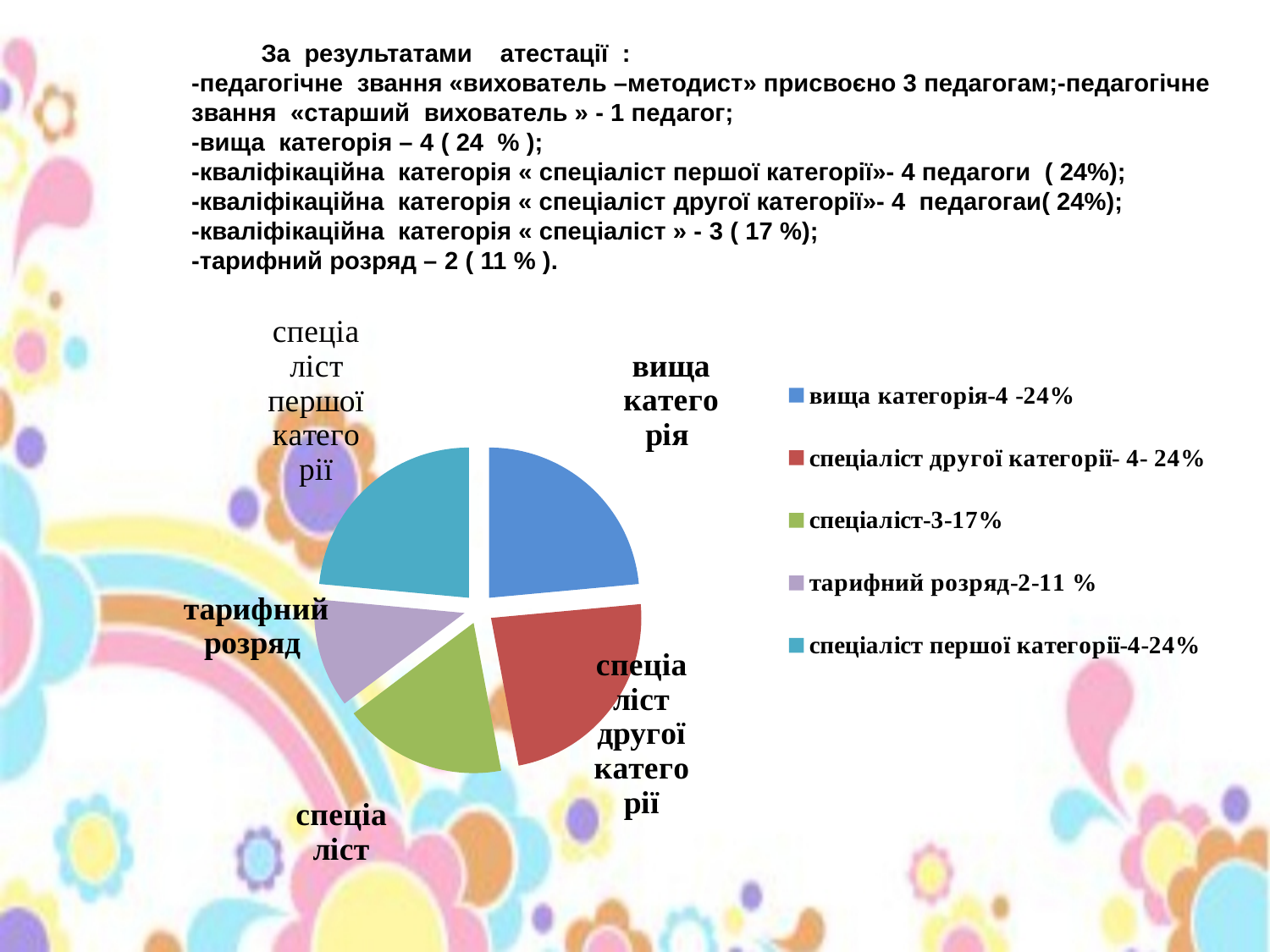
How many slices does the pie chart have? 5 Which category has the smallest slice of the pie? тарифний розряд How many teachers does the legend give for "спеціаліст другої категорії"? 4 What percentage does the legend give for "спеціаліст"? 17% What percentage does the legend give for "вища категорія"? 24% How many entries does the legend of the pie chart list? 5 What is the difference in percentage points between "вища категорія" (24%) and "тарифний розряд" (11 %)? 13 What kind of chart is shown on the slide? pie chart What percentage does the legend give for "тарифний розряд"? 11 % What colour is the slice for "спеціаліст" in the pie chart? green Which is larger, the slice for "спеціаліст" or the slice for "тарифний розряд"? спеціаліст What share of the pie does "спеціаліст першої категорії" represent? 24%